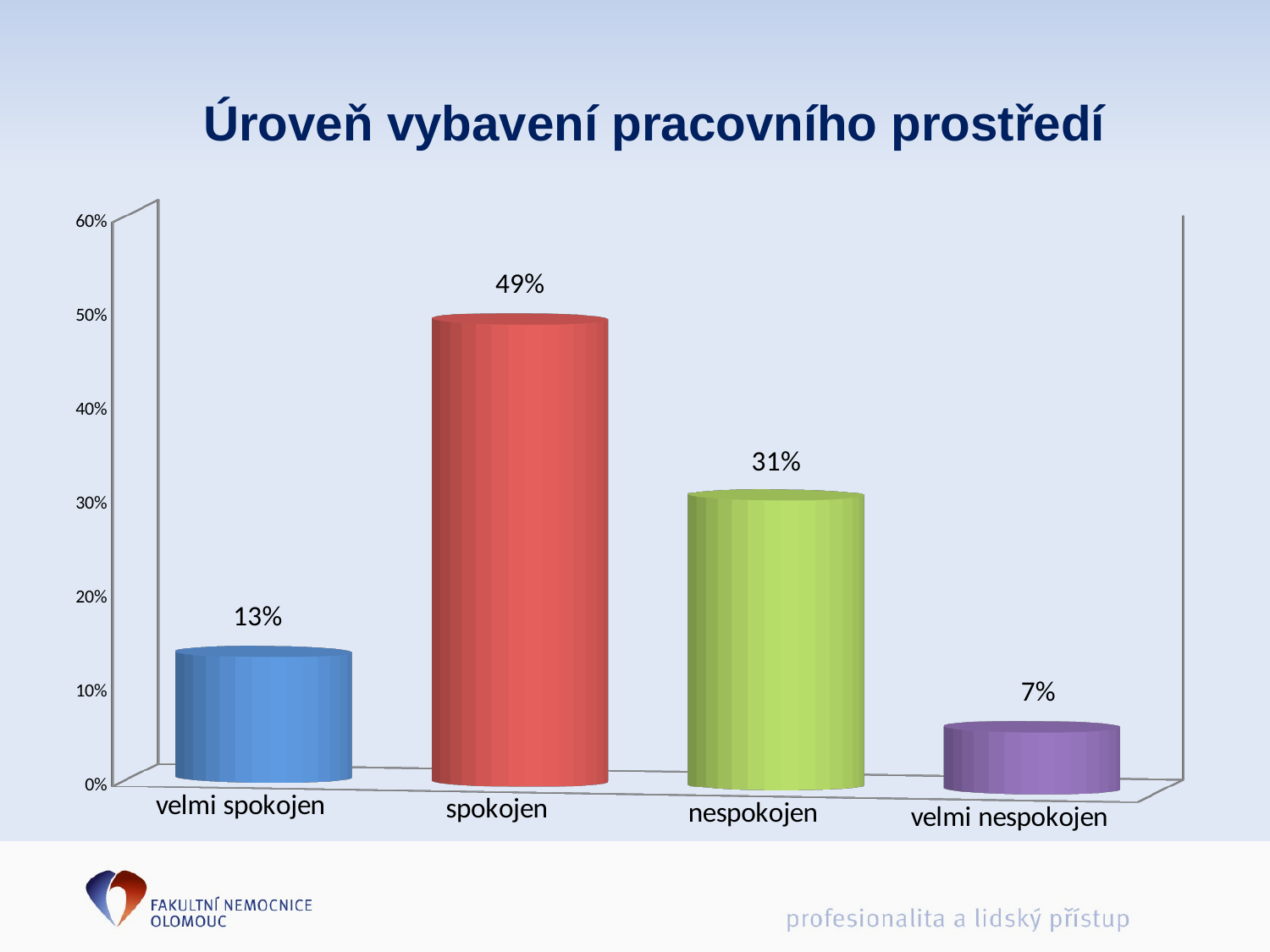
Which is larger, the value for "velmi spokojen" or the value for "nespokojen"? nespokojen What is the difference between the values for "spokojen" and "nespokojen"? 18% Which category has the lowest value? velmi nespokojen What is the value for "nespokojen"? 31% What is the value for "velmi spokojen"? 13% What is the title of the chart? Úroveň vybavení pracovního prostředí What kind of chart is shown on the slide? bar chart Is the value for "spokojen" greater or less than 40%? greater Which category has the highest value? spokojen How many categories are shown on the x axis? 4 What is the value for "spokojen"? 49% What is the value for "velmi nespokojen"? 7%